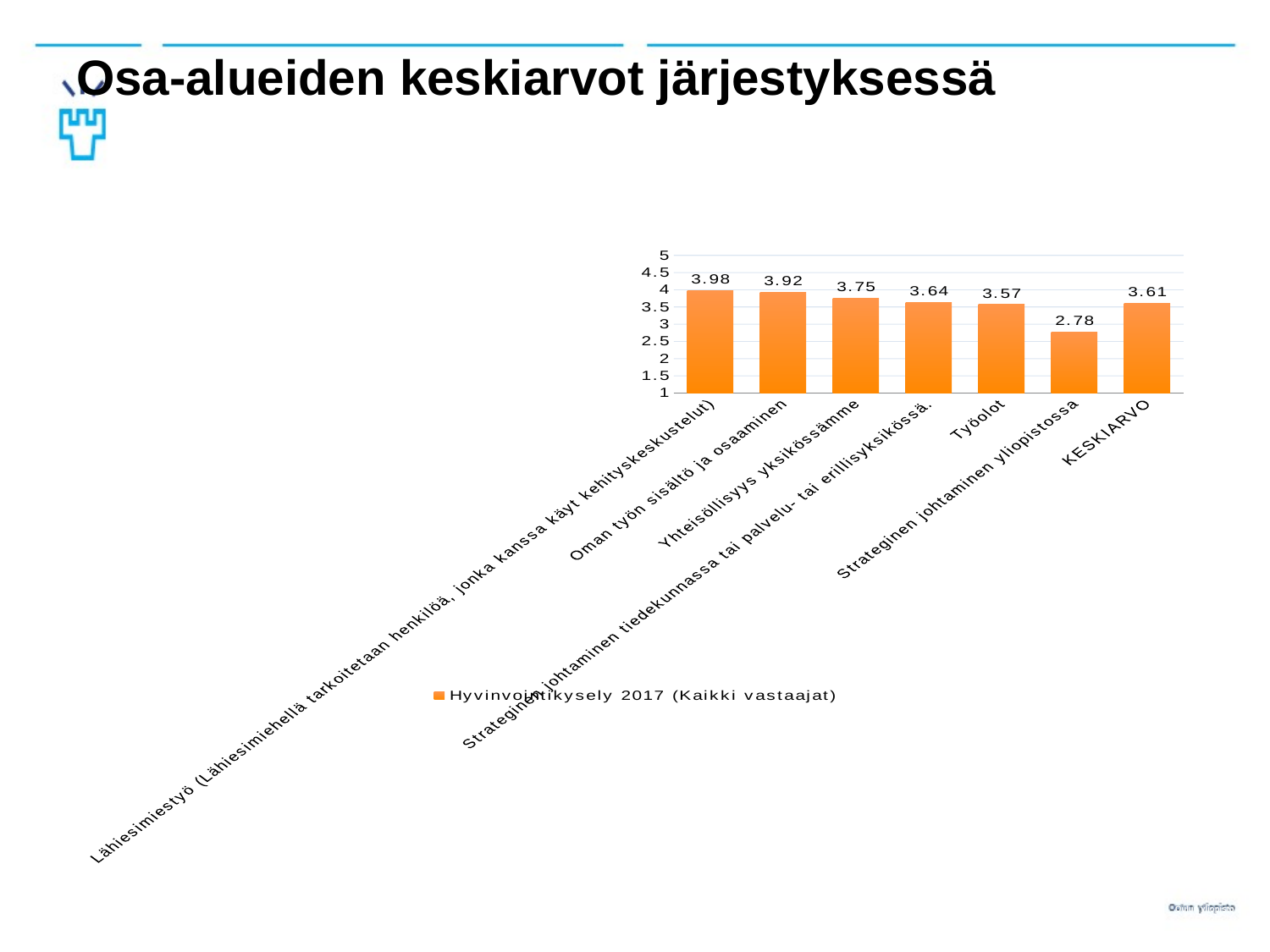
What is the value for Strateginen johtaminen yliopistossa? 2.78 What is the value for Oman työn sisältö ja osaaminen? 3.92 What is the value for KESKIARVO? 3.61 Which category has the lowest value? Strateginen johtaminen yliopistossa Which is larger, the value for Työolot or the value for KESKIARVO? KESKIARVO Which category has the highest value? Lähiesimiestyö (Lähiesimiehellä tarkoitetaan henkilöä, jonka kanssa käyt kehityskeskustelut) Is the value for Strateginen johtaminen yliopistossa greater or less than 3? less How many bars are shown in the chart? 7 What is the value for Työolot? 3.57 What series name does the legend show? Hyvinvointikysely 2017 (Kaikki vastaajat) What is the difference between the values for Yhteisöllisyys yksikössämme and Strateginen johtaminen yliopistossa? 0.97 What kind of chart is shown on the slide? bar chart